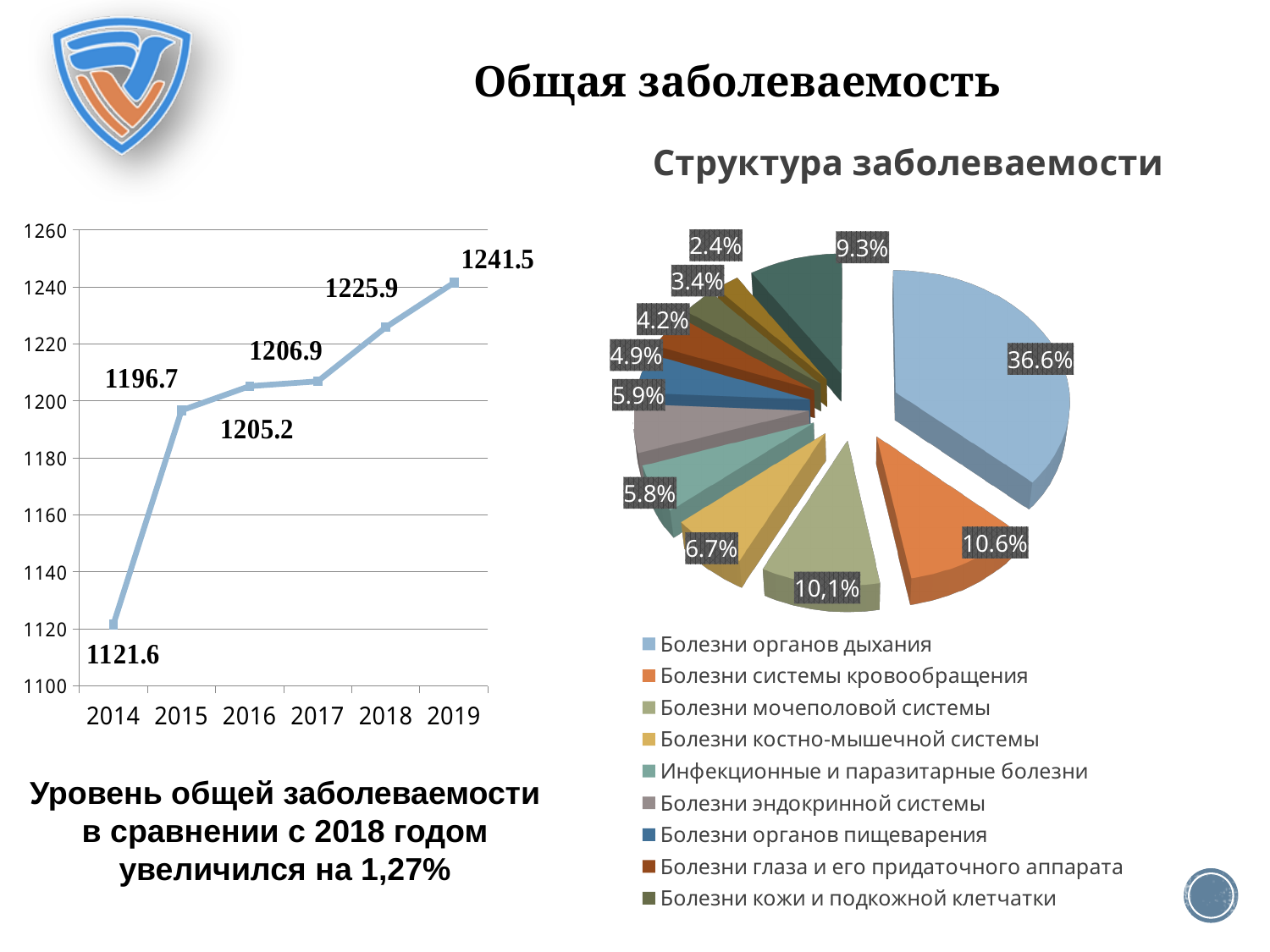
In the pie chart 'Структура заболеваемости', what share does 'Болезни системы кровообращения' have? 10.6% In the line chart on the left, what is the difference between the 2019 and 2018 values? 15.6 How many entries does the legend of the pie chart 'Структура заболеваемости' list? 9 What kind of chart is shown on the left of the slide? line chart In the line chart on the left, what is the value for 2017? 1206.9 How many years are plotted in the line chart on the left? 6 In the line chart on the left, what is the value for 2014? 1121.6 In the line chart on the left, do the values rise or fall from 2014 to 2019? rise In the line chart on the left, which year has the lowest value? 2014 In the line chart on the left, what is the value for 2019? 1241.5 In the pie chart 'Структура заболеваемости', what share does 'Болезни органов дыхания' have? 36.6% In the line chart on the left, which year has the highest value? 2019